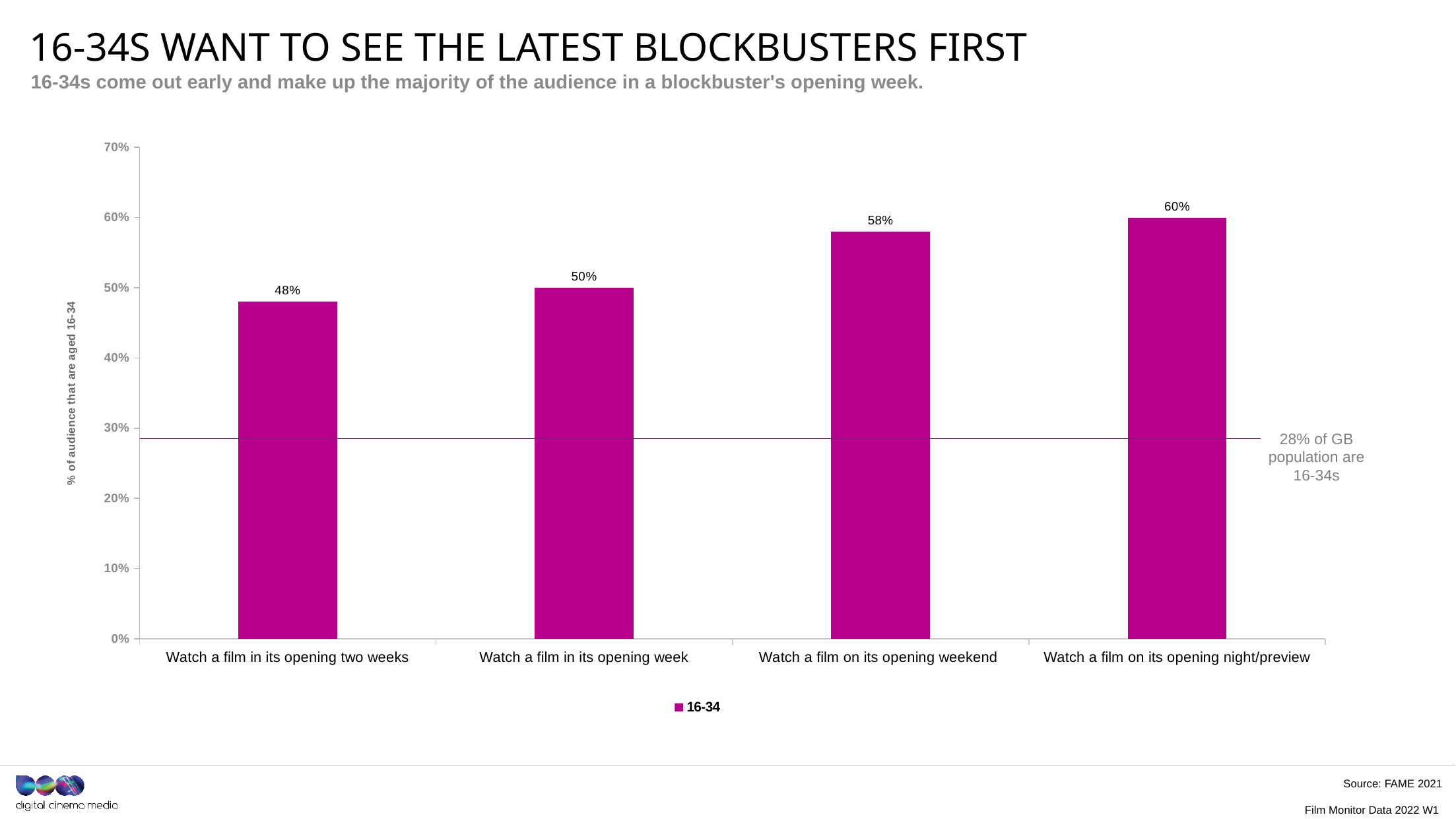
What is the value for 'Watch a film on its opening night/preview'? 60% What percentage of the audience that watch a film in its opening two weeks are aged 16-34? 48% How many series does the legend list? 1 How many categories are shown on the x axis? 4 Do the values rise or fall from left to right along the x axis? rise What kind of chart is shown on the slide? bar chart Which category has the lowest share of 16-34s? Watch a film in its opening two weeks What is the difference between the value for 'Watch a film on its opening night/preview' and 'Watch a film in its opening two weeks'? 12% Is the value for 'Watch a film in its opening week' greater or less than 40%? greater Which category has the highest share of 16-34s? Watch a film on its opening night/preview What is the value for 'Watch a film on its opening weekend'? 58% Which is larger: the value for 'Watch a film in its opening week' or 'Watch a film on its opening weekend'? Watch a film on its opening weekend